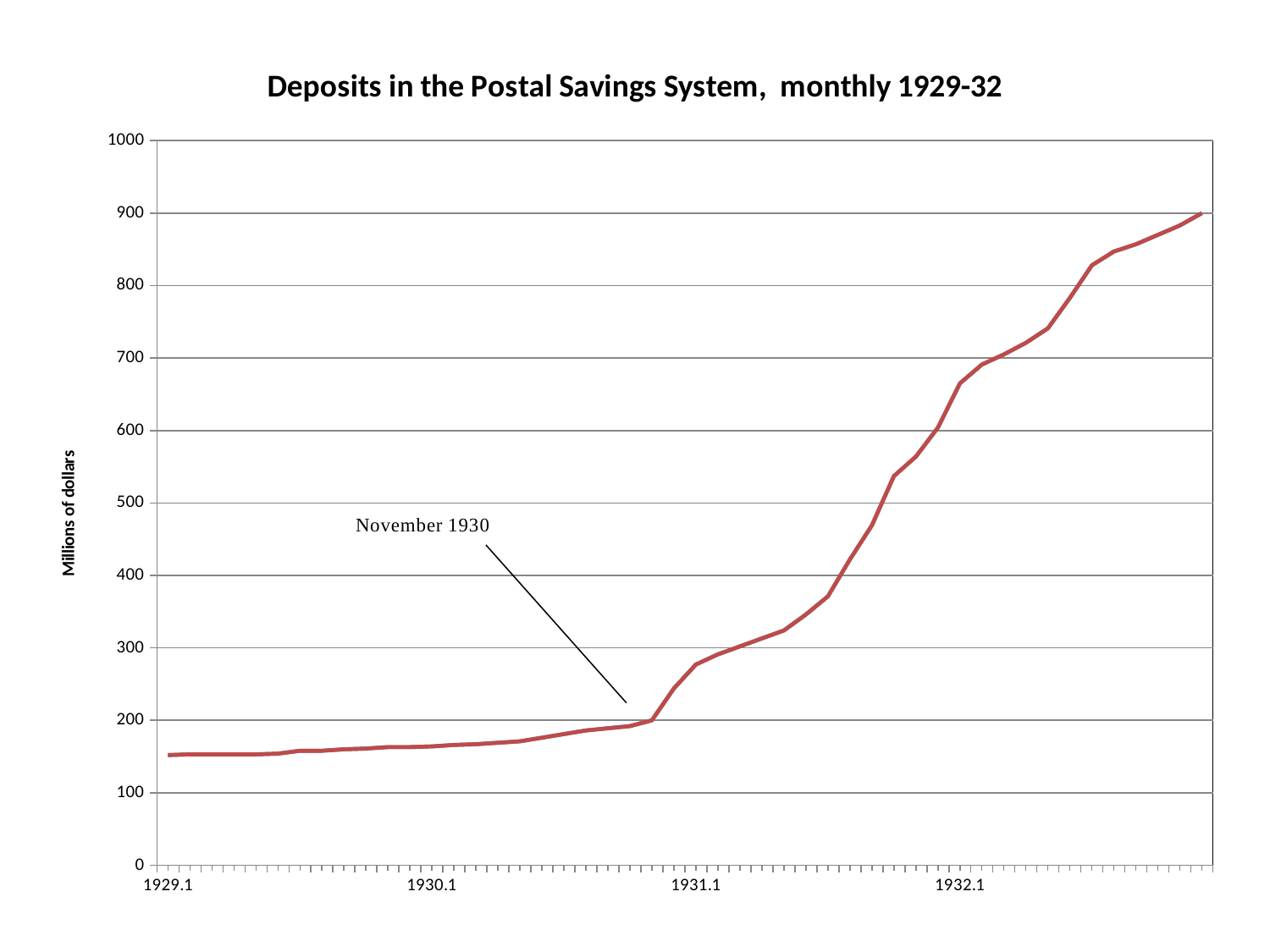
Is the value at 1929.1 greater or less than 200? less Is the value at 1931.1 greater or less than 300? less Is the value at 1931.1 greater or less than 200? greater Which is larger, the value at 1930.1 or the value at 1932.1? 1932.1 What kind of chart is shown on the slide? line chart What is the highest value shown on the vertical axis of the chart? 1000 Do deposits rise or fall over the period shown on the chart? rise What is the title of the chart? Deposits in the Postal Savings System, monthly 1929-32 How many year labels are shown on the horizontal axis of the chart? 4 What is the label on the vertical axis of the chart? Millions of dollars